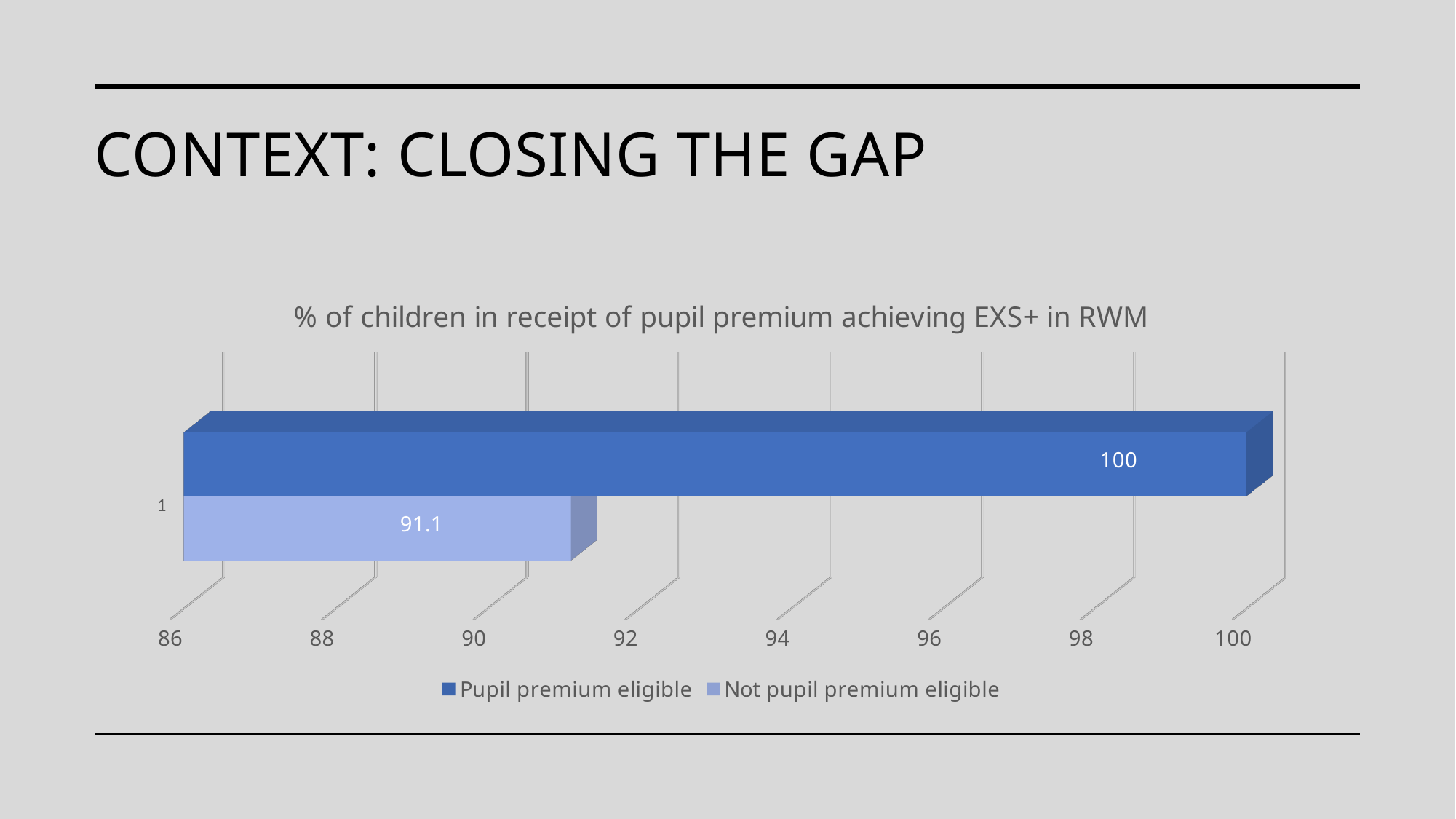
What is the difference between the Pupil premium eligible value and the Not pupil premium eligible value? 8.9 What is the highest value shown on the horizontal axis? 100 What is the value for the Not pupil premium eligible series? 91.1 Is the value for Pupil premium eligible greater or less than 98? greater Which series is shown in the darker blue colour? Pupil premium eligible Is the value for Not pupil premium eligible greater or less than 92? less How many series does the legend list? 2 Which series has the lowest value? Not pupil premium eligible What is the title of the chart? % of children in receipt of pupil premium achieving EXS+ in RWM What is the value for the Pupil premium eligible series? 100 What kind of chart is shown on the slide? Bar chart Which series has the higher value, Pupil premium eligible or Not pupil premium eligible? Pupil premium eligible